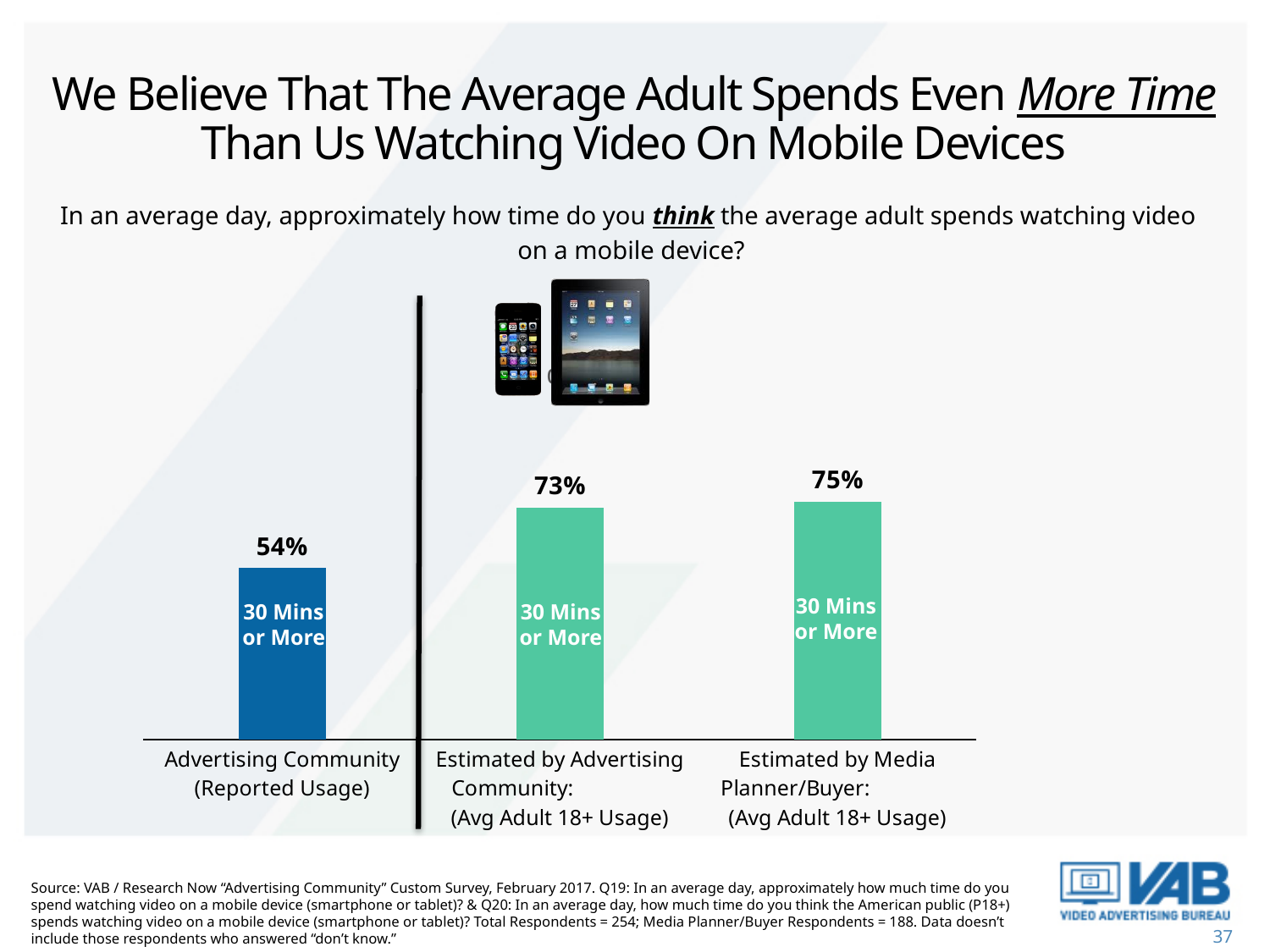
Which is larger: the value for Advertising Community (Reported Usage) or the value for Estimated by Advertising Community? Estimated by Advertising Community What label is printed inside each bar? 30 Mins or More What is the difference between the Estimated by Media Planner/Buyer value and the Advertising Community (Reported Usage) value? 21% Which category has the highest value? Estimated by Media Planner/Buyer: (Avg Adult 18+ Usage) What kind of chart is shown on the slide? Bar chart What colour is the bar for Advertising Community (Reported Usage)? Blue What is the difference between the Estimated by Advertising Community value and the Advertising Community (Reported Usage) value? 19% Which category has the lowest value? Advertising Community (Reported Usage) What percentage is shown for Advertising Community (Reported Usage)? 54% How many bars are shown in the chart? 3 What percentage is shown for Estimated by Advertising Community: (Avg Adult 18+ Usage)? 73% What percentage is shown for Estimated by Media Planner/Buyer: (Avg Adult 18+ Usage)? 75%